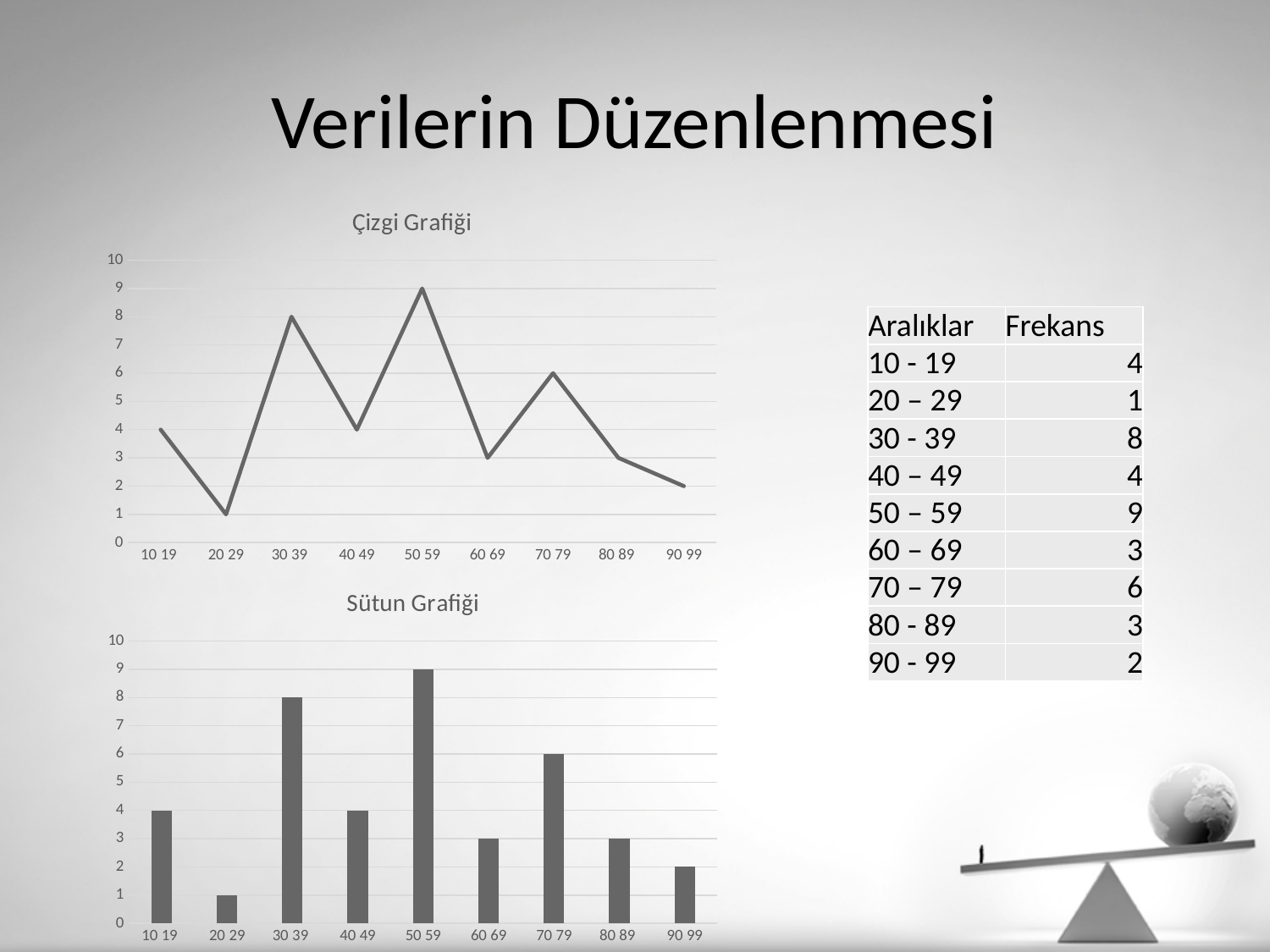
In the chart titled "Sütun Grafiği", what is the difference between the values for 70 79 and 90 99? 4 What kind of chart is the chart titled "Sütun Grafiği"? bar chart In the chart titled "Sütun Grafiği", which category has the highest value? 50 59 How many categories are shown on the x axis of the chart titled "Sütun Grafiği"? 9 In the chart titled "Sütun Grafiği", is the value for 30 39 greater or less than 5? greater What is the title of the lower chart on the slide? Sütun Grafiği In the chart titled "Çizgi Grafiği", what is the value for 30 39? 8 In the chart titled "Çizgi Grafiği", which category has the lowest value? 20 29 What kind of chart is the chart titled "Çizgi Grafiği"? line chart In the chart titled "Çizgi Grafiği", does the line rise or fall from 50 59 to 60 69? fall In the chart titled "Sütun Grafiği", what is the value for 50 59? 9 In the chart titled "Çizgi Grafiği", which is larger, the value for 10 19 or the value for 60 69? 10 19